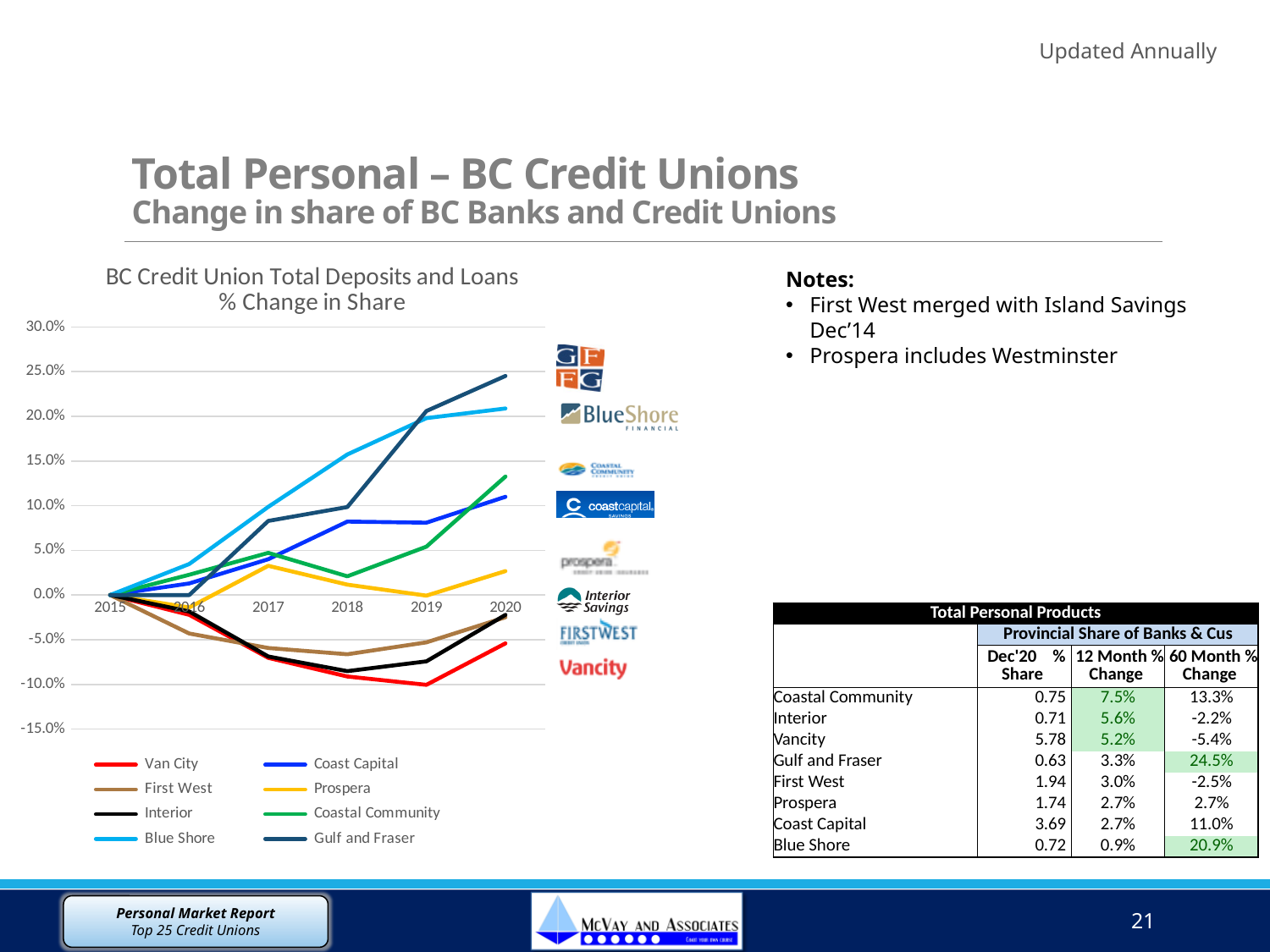
Is the value for Gulf and Fraser in 2020 greater or less than 20.0%? greater In 2020, which is larger: the value for Coast Capital or the value for Prospera? Coast Capital What is the title of the chart? BC Credit Union Total Deposits and Loans % Change in Share How many years are shown along the x axis of the chart? 6 Which credit union has the lowest % change in share in 2019? Van City Is the value for Van City in 2019 greater or less than -5.0%? less Is the value for Coastal Community in 2020 greater or less than 10.0%? greater What colour is the Van City line in the chart? red Which credit union has the highest % change in share in 2020? Gulf and Fraser What kind of chart is shown on the slide? line chart Does the Blue Shore line rise or fall from 2015 to 2020? rise How many series does the chart legend list? 8